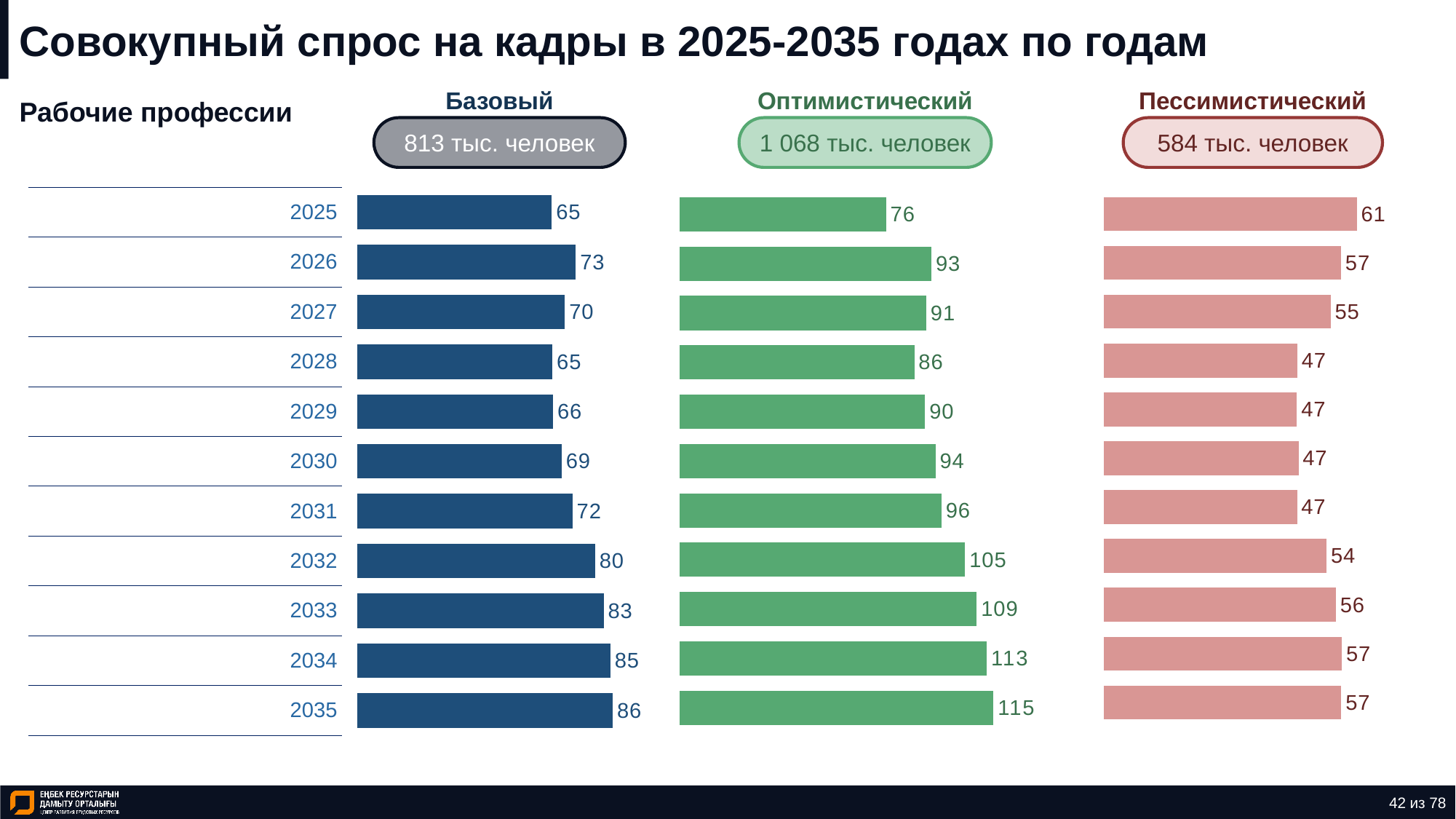
In the Базовый chart, what is the difference between the values for 2035 and 2025? 21 What total is shown in the label above the Оптимистический chart? 1 068 тыс. человек In the Оптимистический chart, which year has the highest value? 2035 In the Оптимистический chart, what is the value for 2029? 90 In the Оптимистический chart, what is the difference between the values for 2033 and 2032? 4 In the Пессимистический chart, what is the value for 2025? 61 In the Базовый chart, what is the value for 2032? 80 In the Базовый chart, which year has the lowest value? 2025 and 2028 What kind of chart is used for the Оптимистический scenario? Bar chart How many years are shown in the Базовый chart? 11 In the Пессимистический chart, which is larger, the value for 2026 or the value for 2028? 2026 In the Пессимистический chart, which year has the highest value? 2025